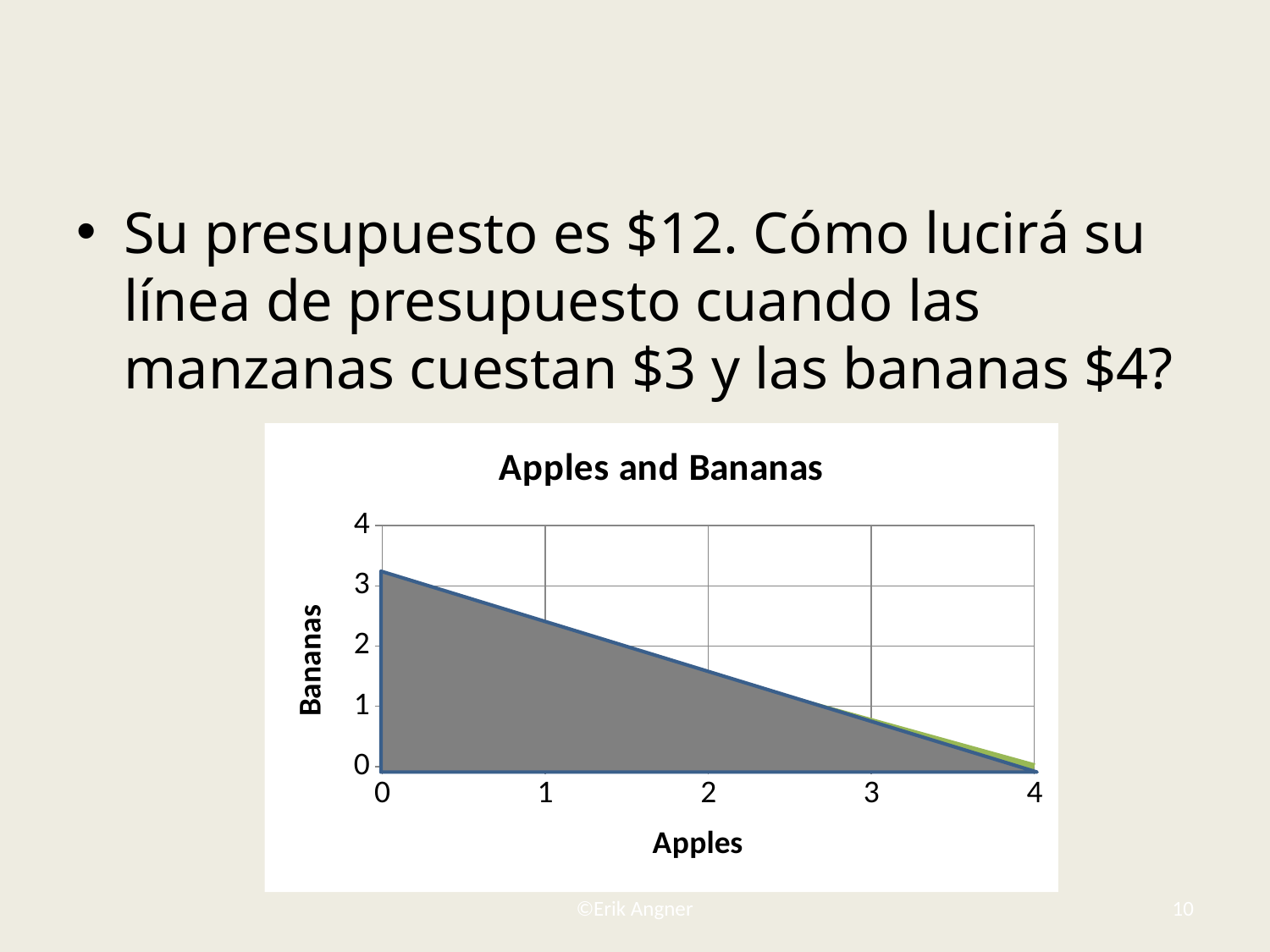
Is the value of Bananas at Apples = 2 greater or less than 2? less What kind of chart is shown on the slide? area chart What is the highest value shown on the vertical axis? 4 Is the value of Bananas at Apples = 1 greater or less than 3? less What is the label of the horizontal axis of the chart? Apples What is the title of the chart? Apples and Bananas At which value of Apples is the plotted Bananas value lowest? 4 Is the value of Bananas at Apples = 0 greater or less than 2? greater What is the value of Bananas when Apples is 4? 0 Does the plotted line rise or fall as Apples increases from 0 to 4? fall At which value of Apples is the plotted Bananas value highest? 0